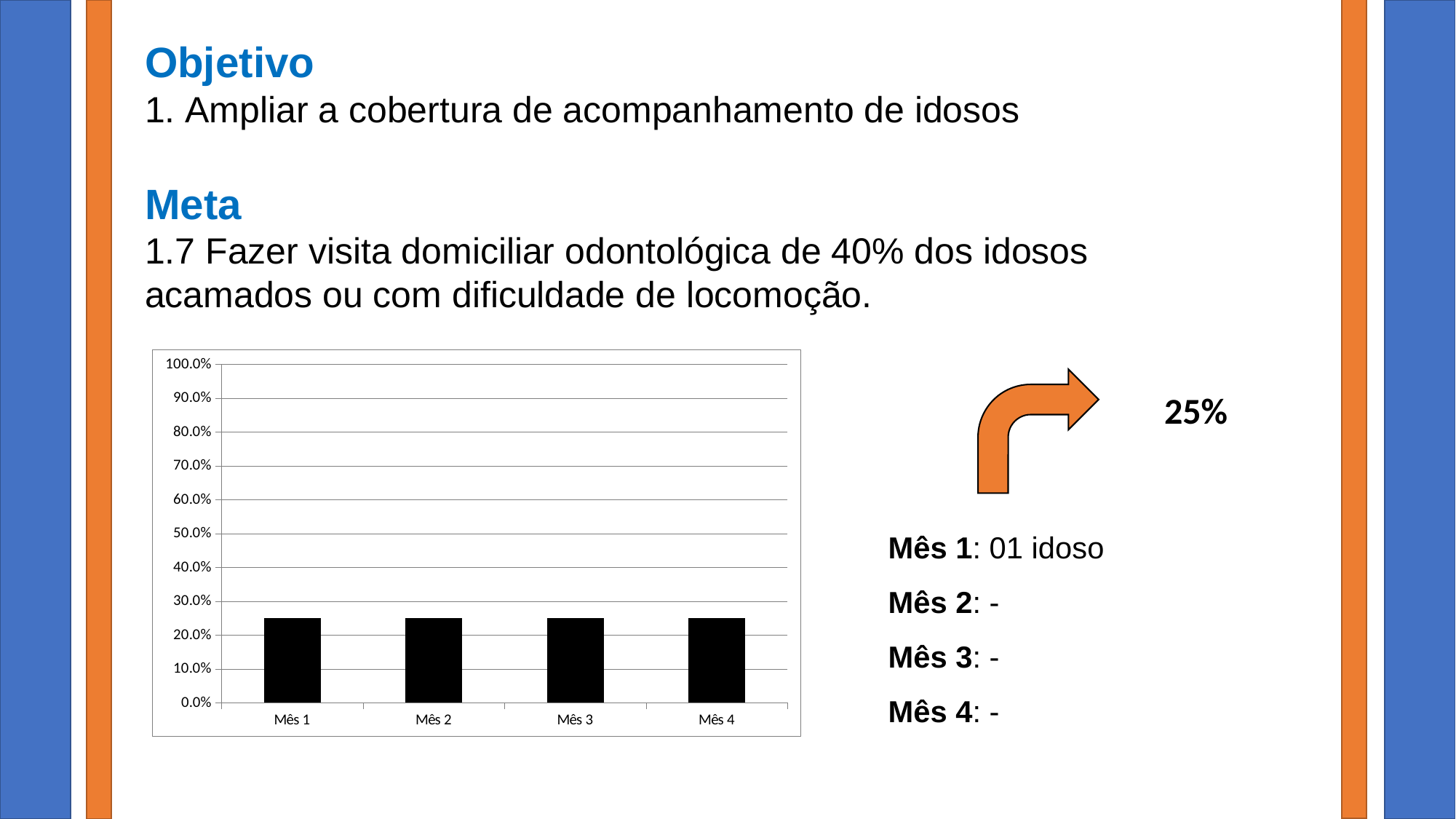
Is the value for Mês 3 greater or less than 40.0%? less Is the value for Mês 2 greater or less than 30.0%? less What is the label of the first category on the x axis? Mês 1 Do the bar values rise, fall, or stay the same from Mês 1 to Mês 4? stay the same What is the highest value shown on the y axis of the chart? 100.0% What kind of chart is shown on the slide? bar chart Is the value for Mês 4 greater or less than 10.0%? greater How many categories (months) are shown on the x axis of the chart? 4